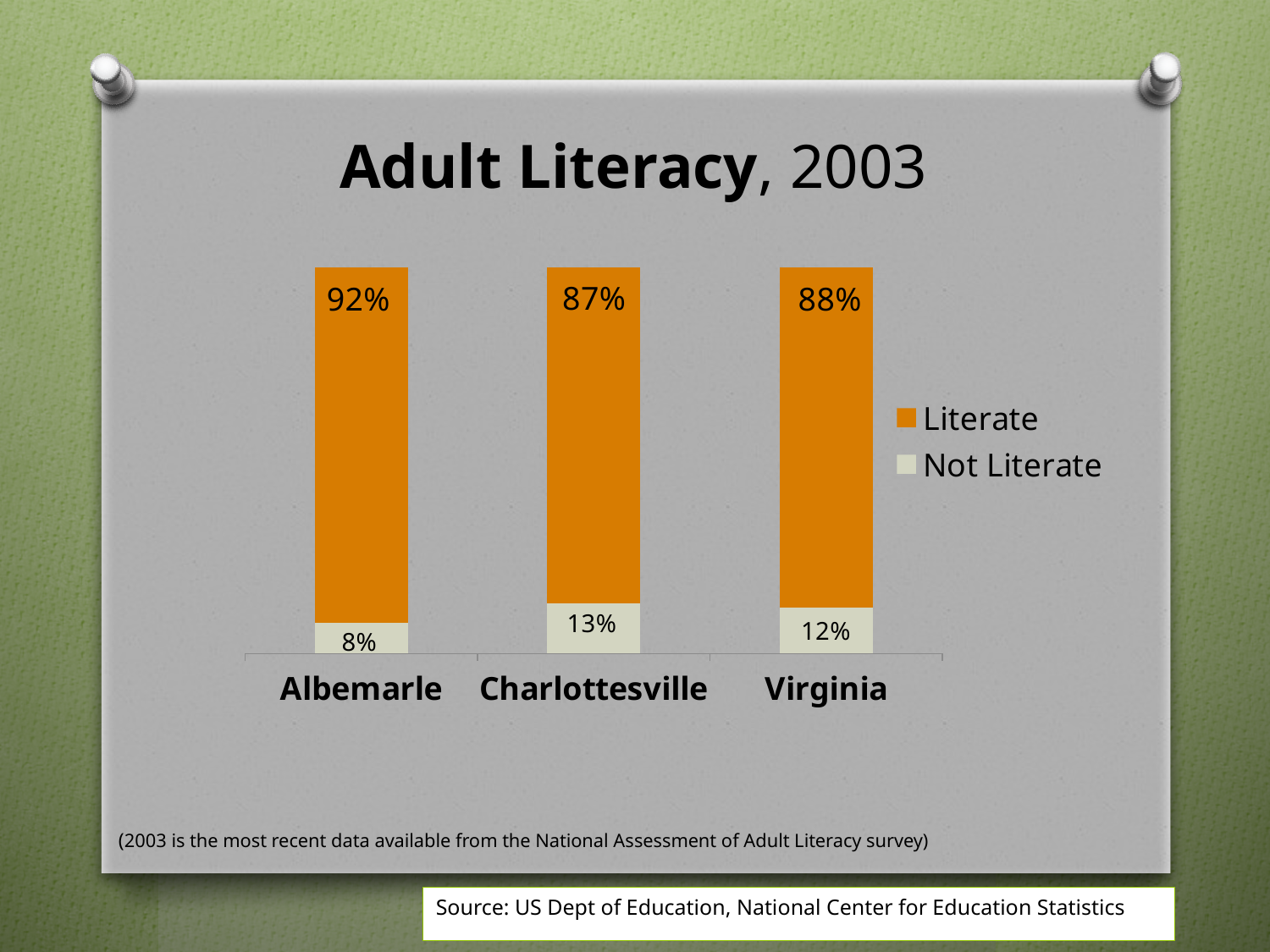
What kind of chart is shown on the slide? Stacked bar chart Which is larger, the Not Literate value for Virginia or for Albemarle? Virginia What is the Literate value for Virginia? 88% What is the difference between the Literate values for Albemarle and Charlottesville? 5% Which category has the lowest Literate value? Charlottesville How many categories are shown on the x axis? 3 Which category has the highest Literate value? Albemarle What is the Literate value for Albemarle? 92% What is the Not Literate value for Charlottesville? 13% What is the total of the stacked bar for Virginia? 100% How many series does the legend list? 2 What is the Not Literate value for Albemarle? 8%